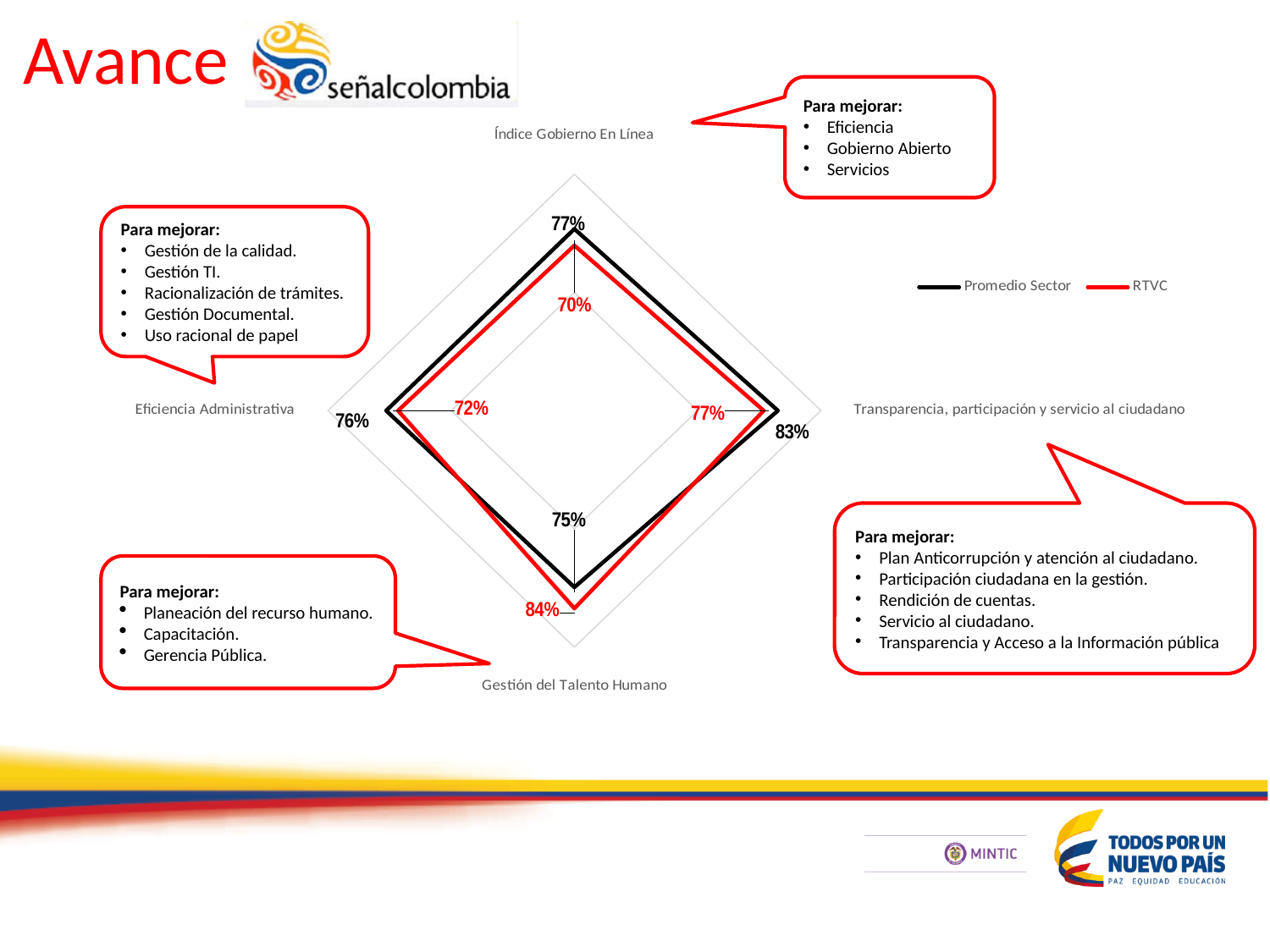
How many categories (axes) does the radar chart have? 4 What is the difference between the Promedio Sector and RTVC values for Índice Gobierno En Línea? 7% What is the RTVC value for Gestión del Talento Humano? 84% How many series does the chart legend list? 2 What is the Promedio Sector value for Transparencia, participación y servicio al ciudadano? 83% In which category does RTVC have its highest value? Gestión del Talento Humano What is the RTVC value for Índice Gobierno En Línea? 70% In which category does Promedio Sector have its lowest value? Gestión del Talento Humano For Gestión del Talento Humano, which series has the larger value, Promedio Sector or RTVC? RTVC What kind of chart is shown on the slide? Radar chart What is the Promedio Sector value for Eficiencia Administrativa? 76% Which two series are listed in the chart legend? Promedio Sector and RTVC